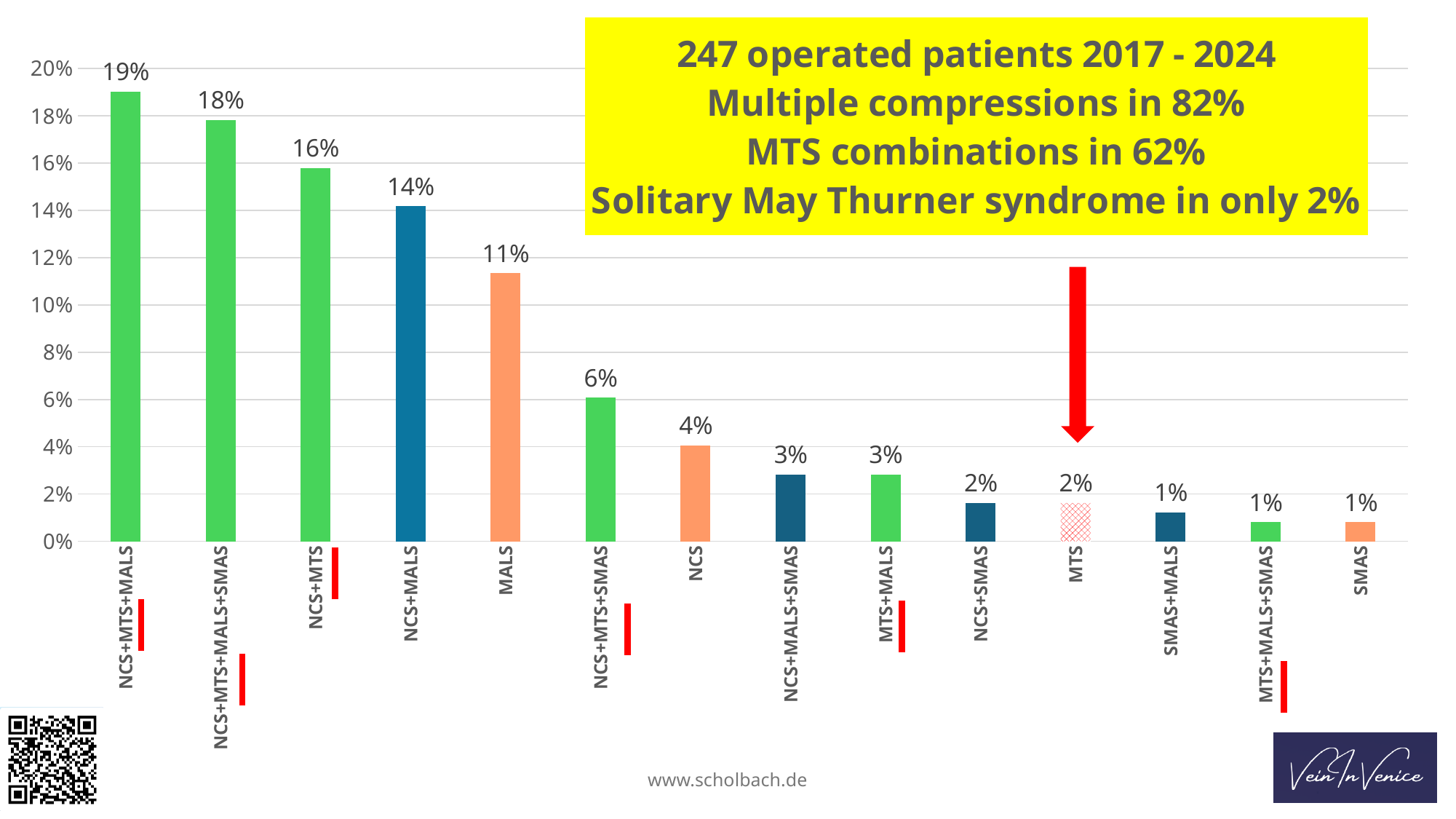
What is the value for NCS+MTS+SMAS? 6% How many categories are shown on the x axis? 14 What is the value for MALS? 11% Do the values rise or fall from left to right along the x axis? fall What kind of chart is shown on the slide? bar chart Which is larger, the value for MALS or the value for NCS? MALS What is the difference between the values for NCS+MTS and NCS? 12% What is the value for MTS? 2% What is the value for NCS+MALS? 14% What is the value for NCS+MTS+MALS? 19% What is the difference between the values for NCS+MTS+MALS and NCS+MALS? 5% Which category has the highest value? NCS+MTS+MALS